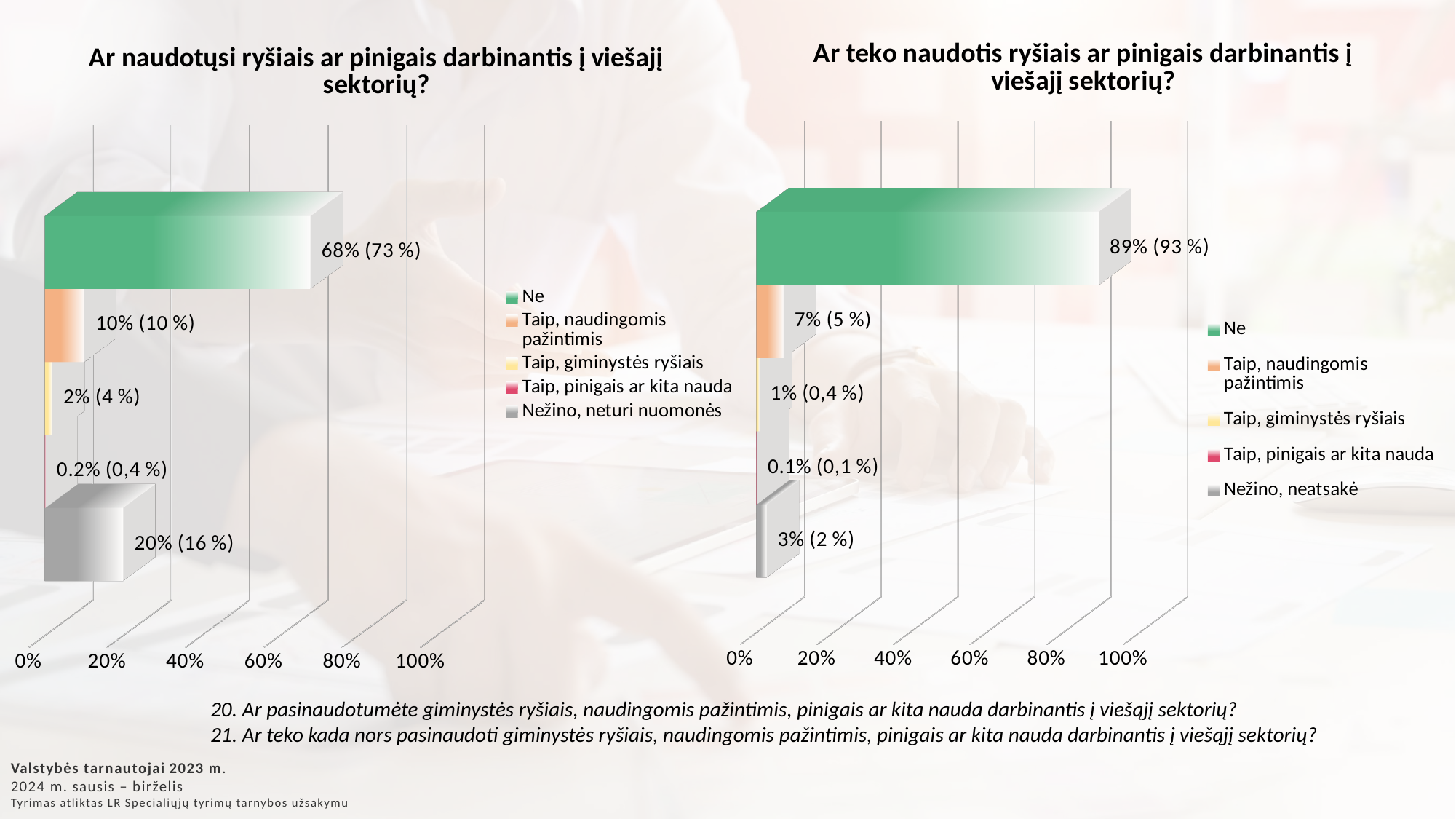
In the left chart (Ar naudotųsi ryšiais ar pinigais darbinantis į viešąjį sektorių?), what is the data label for "Nežino, neturi nuomonės"? 20% (16 %) In the left chart (Ar naudotųsi ryšiais ar pinigais darbinantis į viešąjį sektorių?), which category has the highest value? Ne In the left chart (Ar naudotųsi ryšiais ar pinigais darbinantis į viešąjį sektorių?), what is the data label for "Ne"? 68% (73 %) In the left chart (Ar naudotųsi ryšiais ar pinigais darbinantis į viešąjį sektorių?), what is the data label for "Taip, pinigais ar kita nauda"? 0.2% (0,4 %) In the right chart (Ar teko naudotis ryšiais ar pinigais darbinantis į viešąjį sektorių?), which category has the lowest value? Taip, pinigais ar kita nauda In the left chart (Ar naudotųsi ryšiais ar pinigais darbinantis į viešąjį sektorių?), which is larger: "Taip, naudingomis pažintimis" or "Nežino, neturi nuomonės"? Nežino, neturi nuomonės What type of chart is the left chart (Ar naudotųsi ryšiais ar pinigais darbinantis į viešąjį sektorių?)? Bar chart In the right chart (Ar teko naudotis ryšiais ar pinigais darbinantis į viešąjį sektorių?), is the value for "Ne" greater or less than 80%? greater In the right chart (Ar teko naudotis ryšiais ar pinigais darbinantis į viešąjį sektorių?), what is the data label for "Nežino, neatsakė"? 3% (2 %) How many legend entries does the right chart (Ar teko naudotis ryšiais ar pinigais darbinantis į viešąjį sektorių?) list? 5 In the right chart (Ar teko naudotis ryšiais ar pinigais darbinantis į viešąjį sektorių?), what is the data label for "Ne"? 89% (93 %) In the right chart (Ar teko naudotis ryšiais ar pinigais darbinantis į viešąjį sektorių?), what is the data label for "Taip, naudingomis pažintimis"? 7% (5 %)